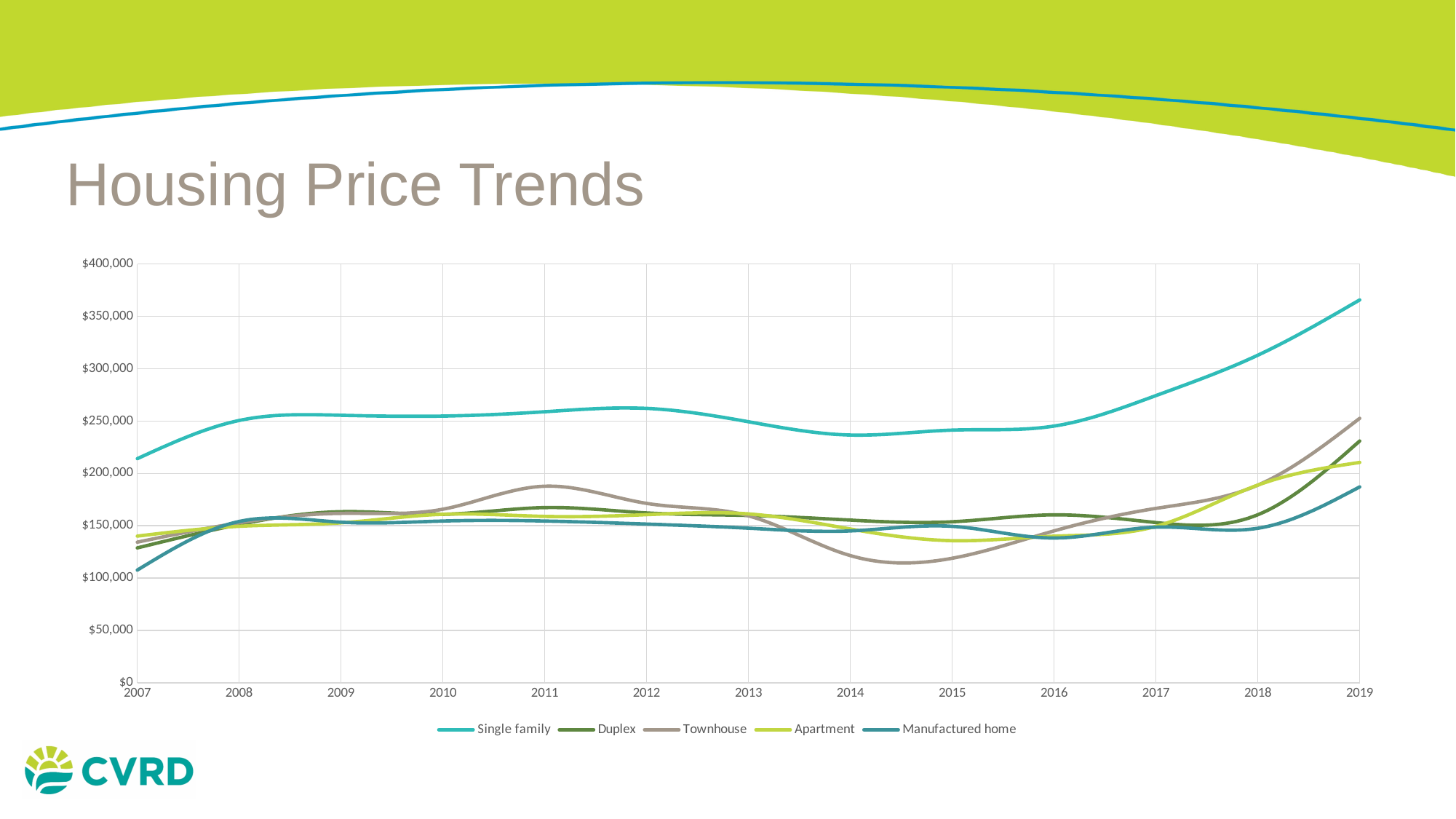
Does the Single family line rise or fall between 2016 and 2019? rise What is the title of the slide containing the chart? Housing Price Trends Is the Single family value in 2007 greater or less than $200,000? greater How many years are shown along the x axis? 13 What kind of chart is shown on the slide? line chart Which series has the highest value in 2019? Single family Is the Townhouse value in 2014 greater or less than $150,000? less Which series has the lowest value in 2007? Manufactured home Is the Single family value in 2019 greater or less than $350,000? greater Which series has the lowest value in 2019? Manufactured home In 2019, which is larger: the Townhouse value or the Duplex value? Townhouse How many series does the legend list? 5